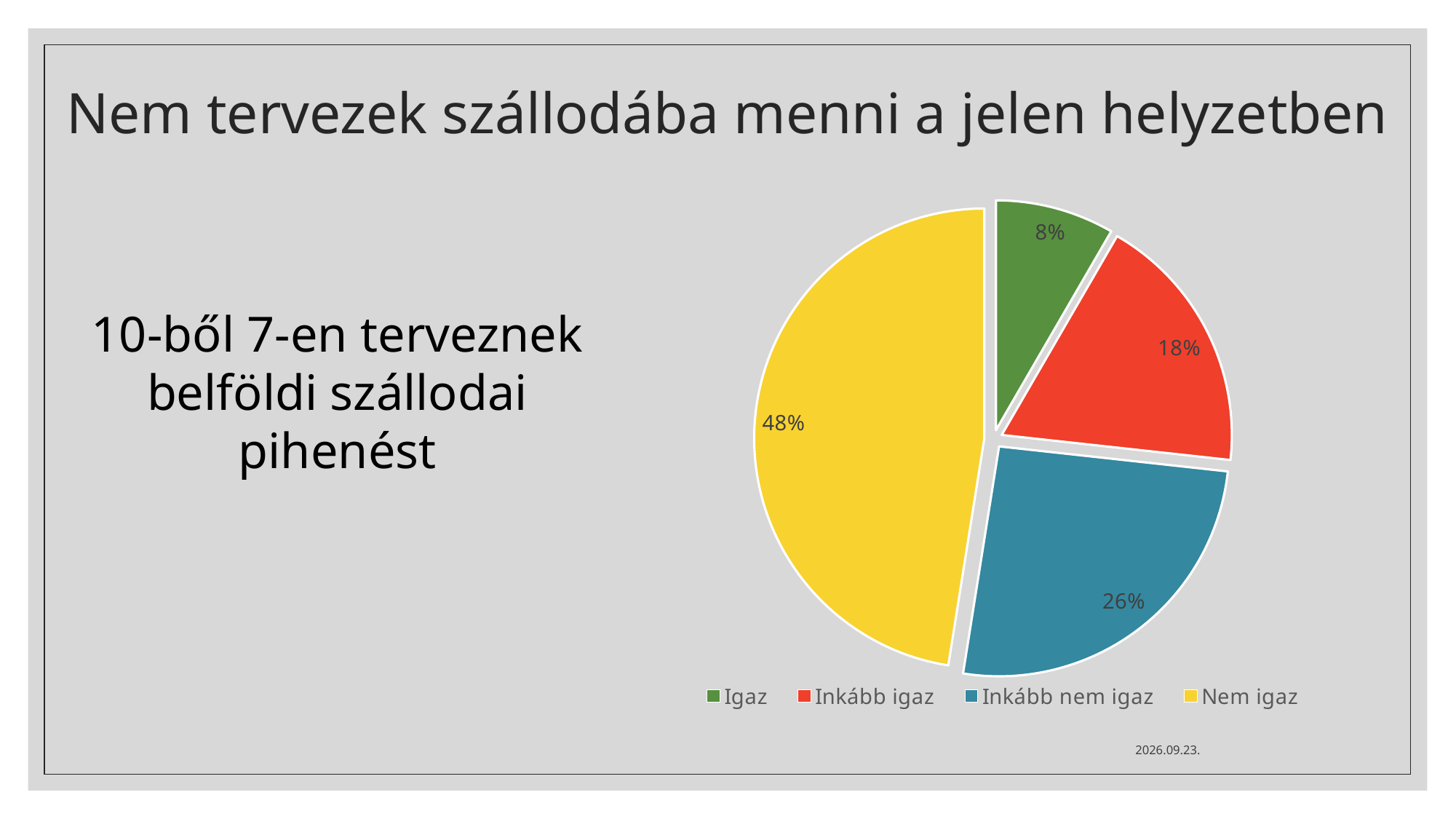
What percentage of the pie is labelled "Nem igaz"? 48% What colour is the slice for "Nem igaz"? yellow What kind of chart is shown on the slide? pie chart Which is larger, the slice for "Inkább igaz" or the slice for "Inkább nem igaz"? Inkább nem igaz What percentage of the pie is labelled "Igaz"? 8% What is the difference in percentage points between "Nem igaz" and "Inkább nem igaz"? 22 Which category has the largest slice of the pie? Nem igaz What percentage of the pie is labelled "Inkább igaz"? 18% What percentage of the pie is labelled "Inkább nem igaz"? 26% Which category has the smallest slice of the pie? Igaz How many entries does the legend list? 4 How many slices does the pie chart have? 4